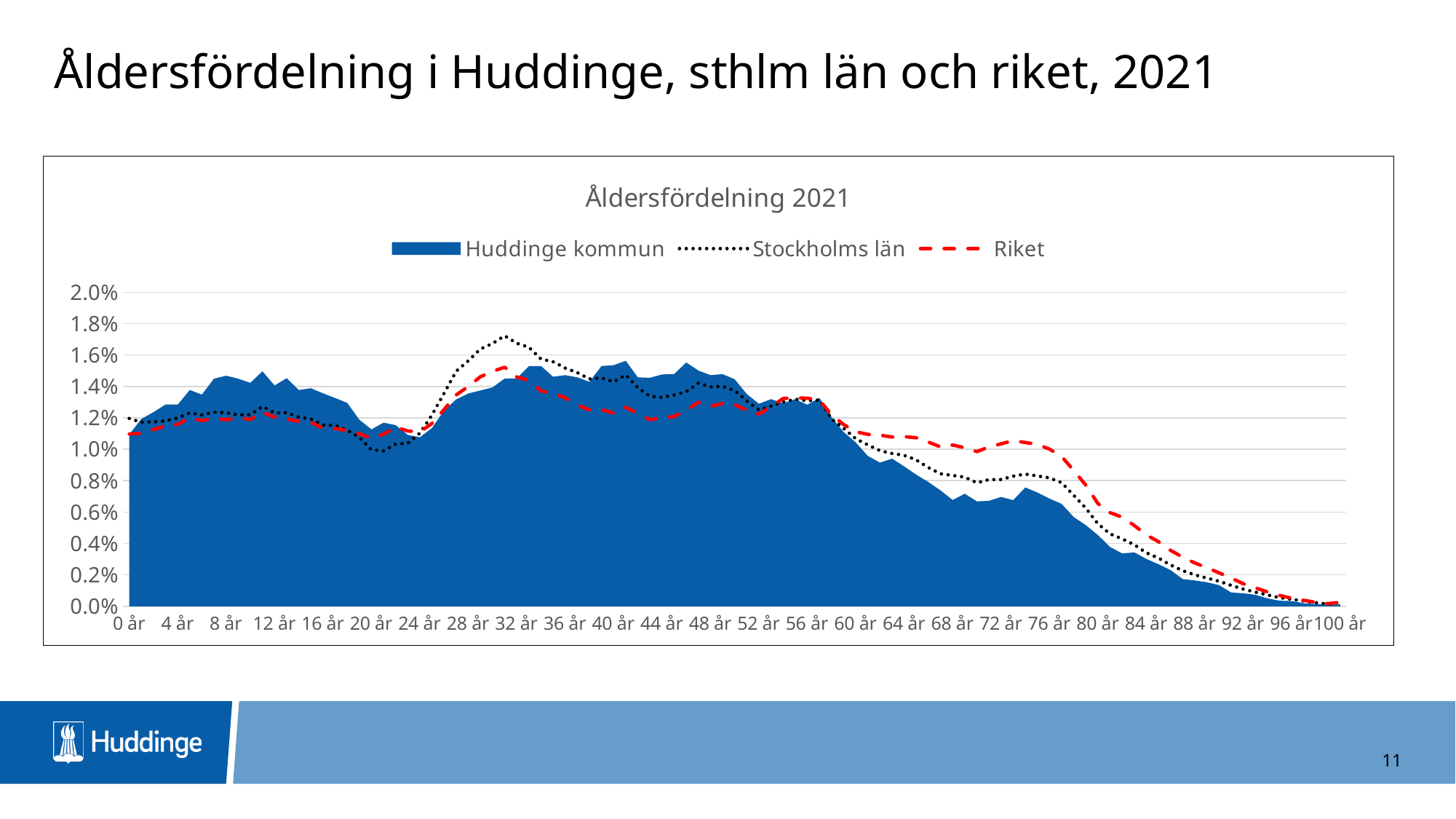
Is the value for Huddinge kommun at 8 år greater or less than 1.2%? greater How many series does the chart legend list? 3 Is the value for Huddinge kommun at 76 år greater or less than 0.8%? less Is the value for Stockholms län at 20 år greater or less than 1.2%? less What is the title of the chart? Åldersfördelning 2021 From 60 år to 100 år, do the values for Huddinge kommun rise or fall? fall What kind of chart is shown on the slide? Area chart with line series At 76 år, which is higher: Riket or Huddinge kommun? Riket Which series is drawn as a red dashed line? Riket At 32 år, which is higher: Stockholms län or Huddinge kommun? Stockholms län